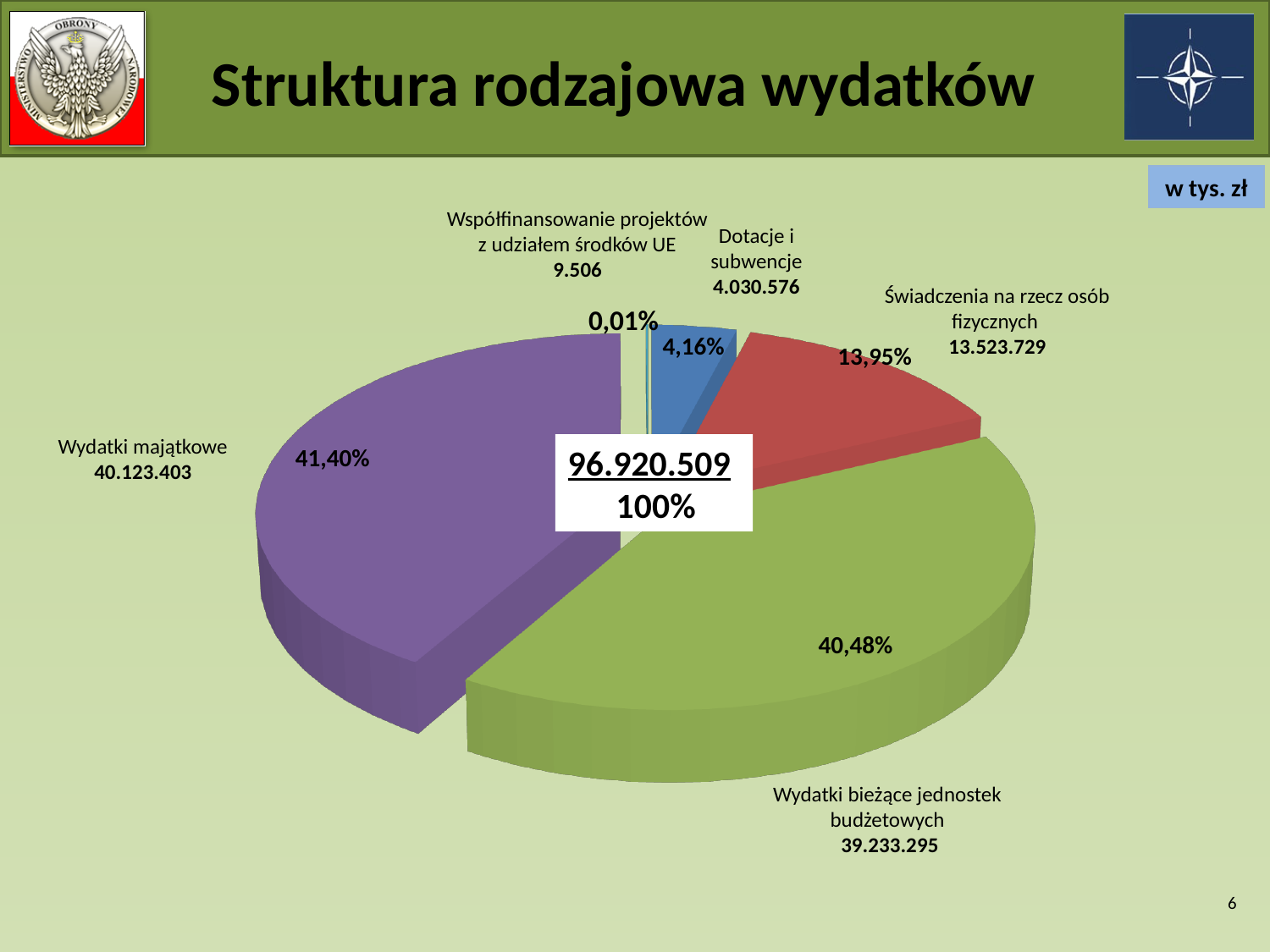
What is the value for Wydatki majątkowe? 40.123.403 What total value is shown in the centre of the pie chart? 96.920.509 Which category has the largest share of the pie? Wydatki majątkowe How many slices does the pie chart have? 5 What is the value for Dotacje i subwencje? 4.030.576 What type of chart is shown on the slide? pie chart What share of the pie does Wydatki bieżące jednostek budżetowych represent? 40,48% What is the value for Współfinansowanie projektów z udziałem środków UE? 9.506 What share of the pie does Świadczenia na rzecz osób fizycznych represent? 13,95% What is the difference between the values for Wydatki majątkowe and Wydatki bieżące jednostek budżetowych? 890.108 Which category has the smallest share of the pie? Współfinansowanie projektów z udziałem środków UE What is the value for Świadczenia na rzecz osób fizycznych? 13.523.729